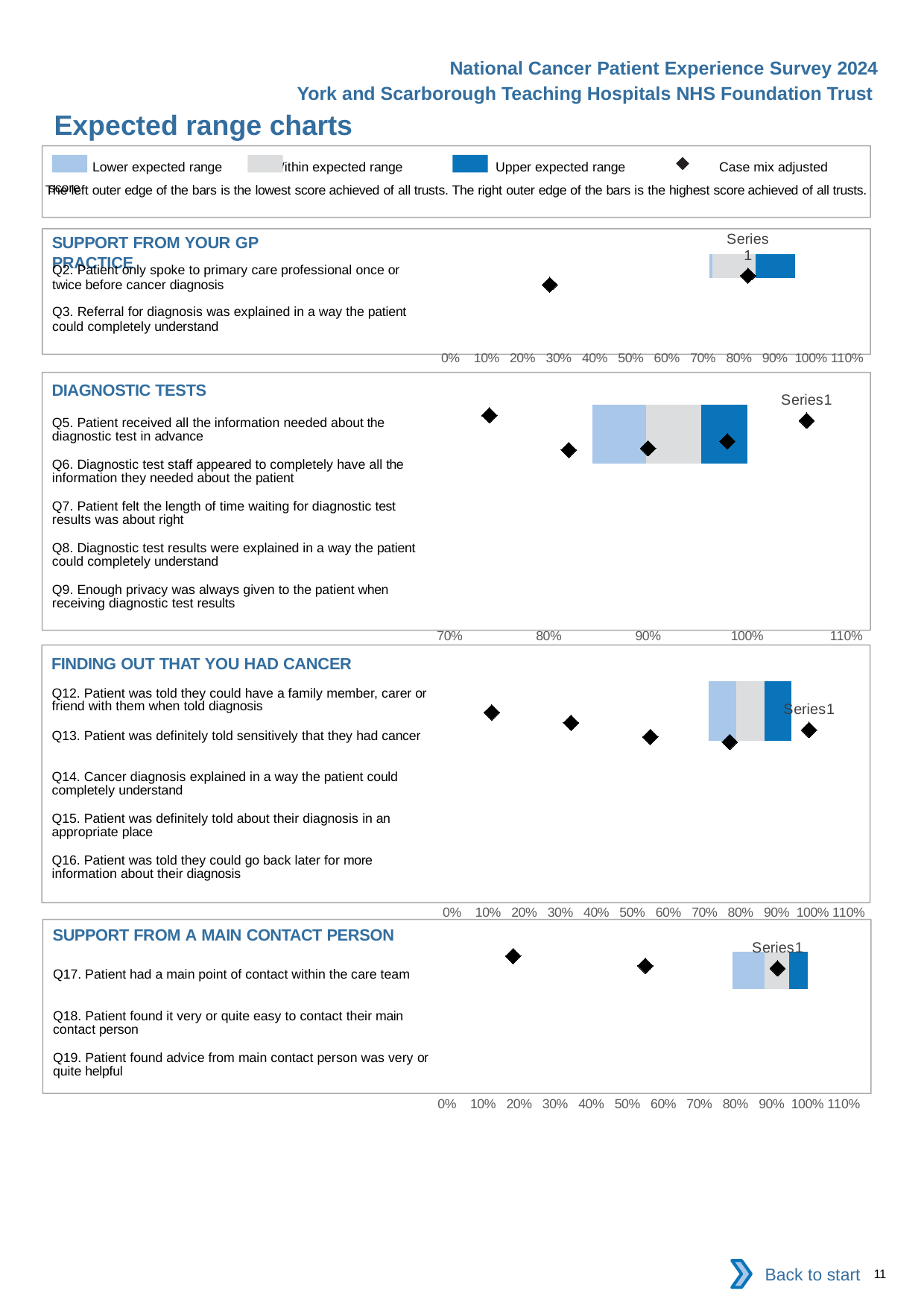
How many charts are shown on the slide? 4 In the DIAGNOSTIC TESTS chart, is the left edge of the shaded expected range bar greater or less than 80%? greater How many questions are listed in the DIAGNOSTIC TESTS chart? 5 How many questions are listed in the SUPPORT FROM A MAIN CONTACT PERSON chart? 3 In the DIAGNOSTIC TESTS chart, what is the lowest value shown on the x axis? 70% According to the legend, what does the diamond marker represent? Case mix adjusted score What kind of chart is used in the DIAGNOSTIC TESTS section? bar chart